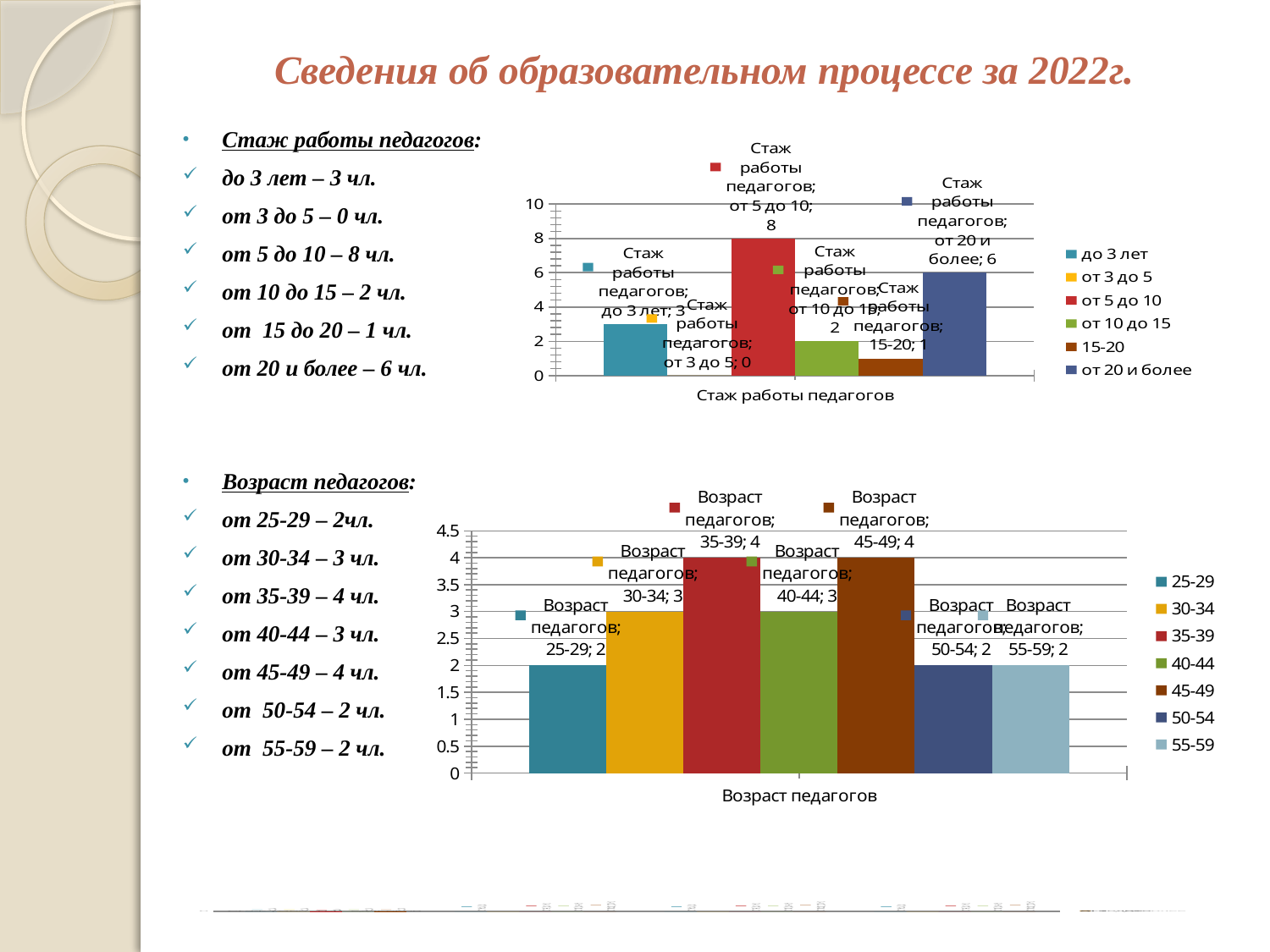
In the 'Возраст педагогов' chart, which is larger, the value for '35-39' or the value for '25-29'? 35-39 In the 'Стаж работы педагогов' chart, what is the difference between 'от 5 до 10' and 'от 20 и более'? 2 How many series does the legend of the 'Стаж работы педагогов' chart list? 6 In the 'Стаж работы педагогов' chart, what is the value for 'от 5 до 10'? 8 In the 'Стаж работы педагогов' chart, which series has the lowest value? от 3 до 5 In the 'Возраст педагогов' chart, what is the difference between '45-49' and '55-59'? 2 What kind of chart is the 'Стаж работы педагогов' chart? bar chart How many series does the legend of the 'Возраст педагогов' chart list? 7 In the 'Возраст педагогов' chart, what is the value for '30-34'? 3 In the 'Стаж работы педагогов' chart, what is the value for 'от 20 и более'? 6 In the 'Возраст педагогов' chart, what is the value for '50-54'? 2 In the 'Стаж работы педагогов' chart, which series has the highest value? от 5 до 10